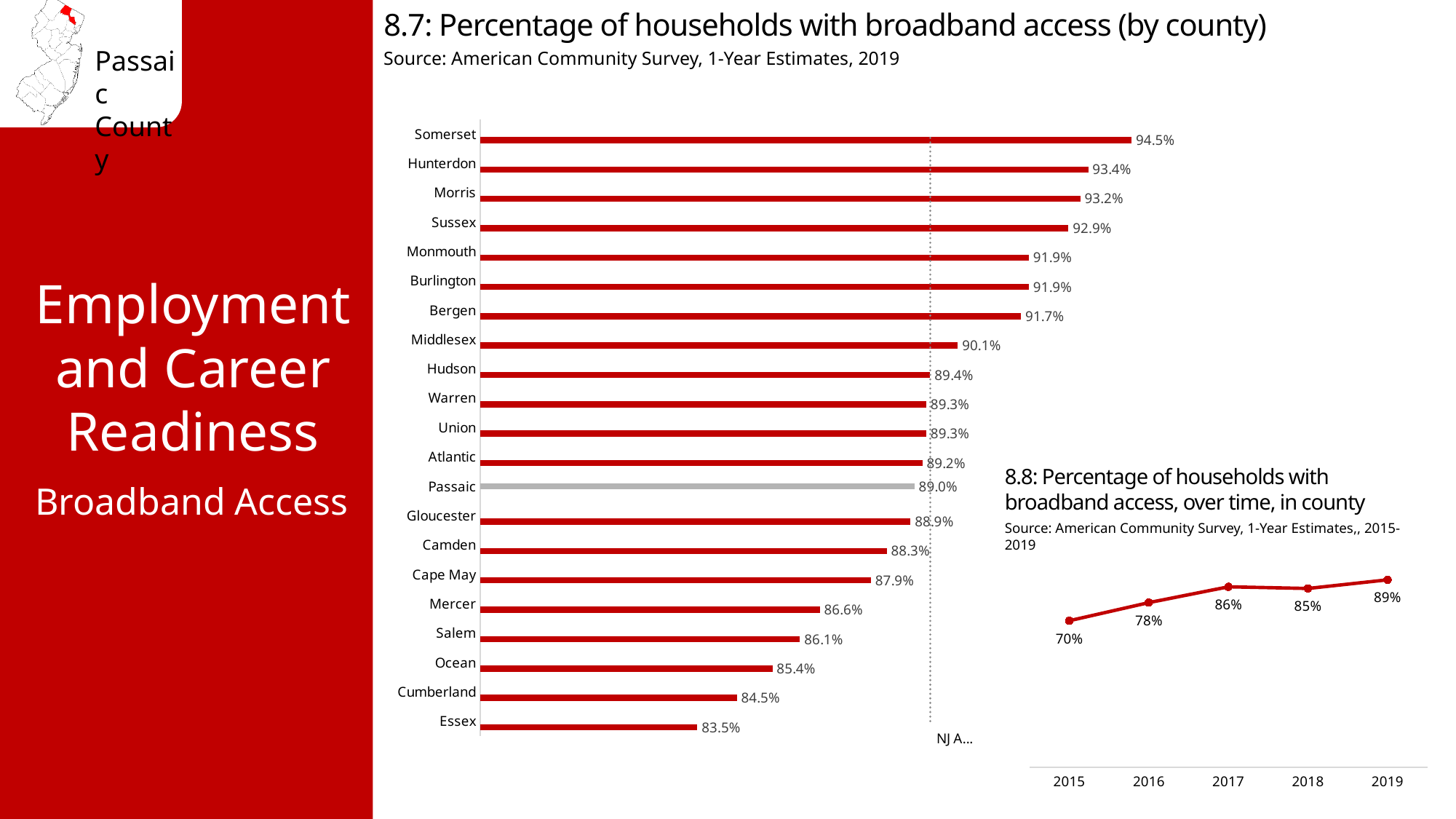
In chart 8.7 (by county), which county has the lowest percentage of households with broadband access? Essex What kind of chart is chart 8.7 (by county)? Bar chart In chart 8.8 (over time, in county), what is the value for 2019? 89% In chart 8.7 (by county), what is the value for Middlesex? 90.1% In chart 8.7 (by county), which is larger, the value for Bergen or the value for Camden? Bergen In chart 8.7 (by county), what is the difference between Somerset and Essex? 11.0% In chart 8.8 (over time, in county), what is the difference between the 2019 and 2015 values? 19% In chart 8.7 (by county), which county has the highest percentage of households with broadband access? Somerset In chart 8.8 (over time, in county), what is the value for 2015? 70% In chart 8.7 (Percentage of households with broadband access by county), what is the value for Passaic? 89.0% In chart 8.8 (over time, in county), do the values generally rise or fall from 2015 to 2019? Rise In chart 8.7 (by county), how many counties are shown? 21